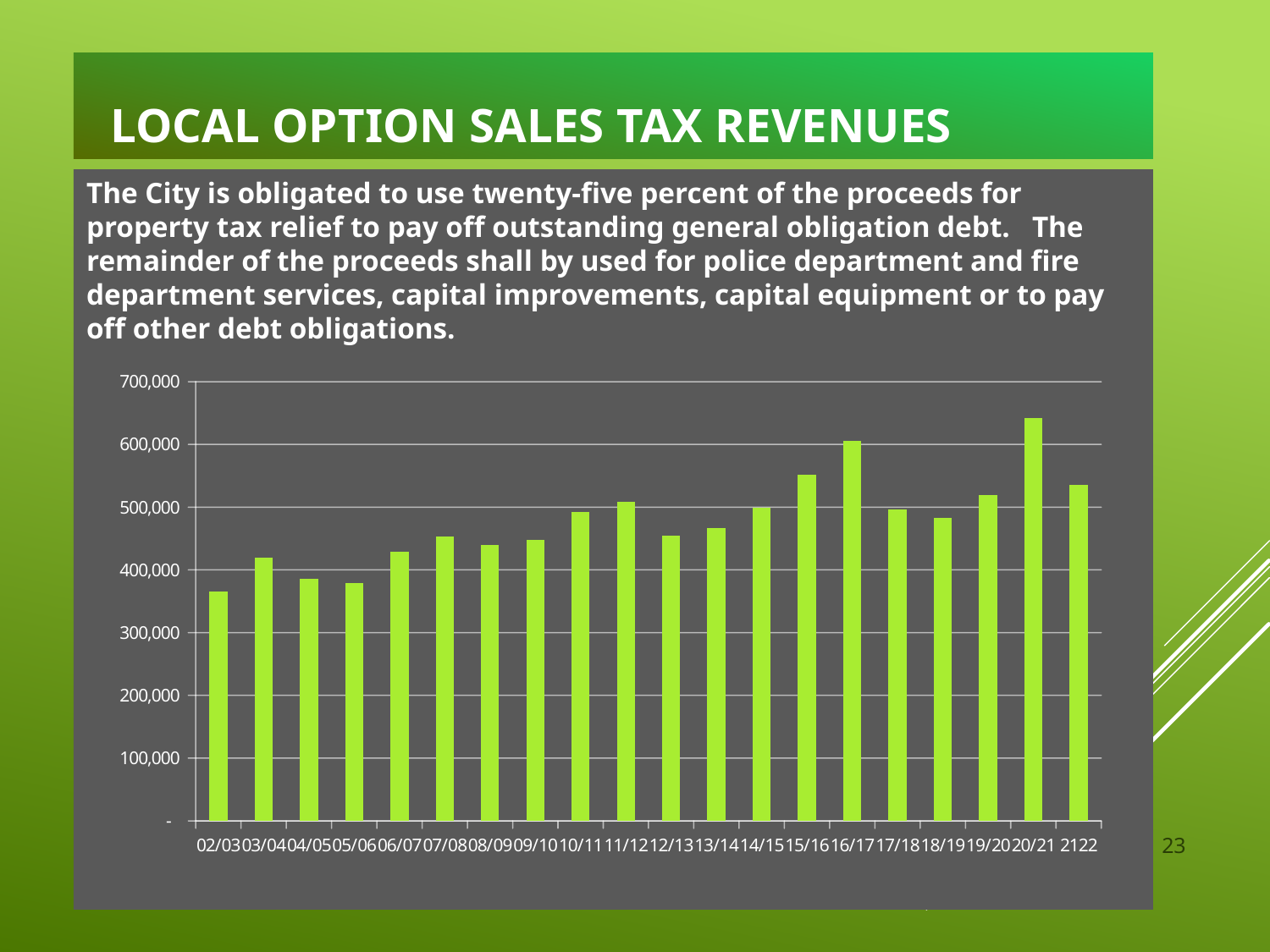
Is the value for 18/19 greater or less than 500,000? less Which fiscal year has the highest local option sales tax revenue? 20/21 Overall, do the revenues rise or fall from 02/03 to 20/21? rise Which fiscal year has the lowest local option sales tax revenue? 02/03 What kind of chart is shown on the slide? bar chart Is the value for 02/03 greater or less than 400,000? less Which is larger, the value for 15/16 or the value for 14/15? 15/16 Is the value for 20/21 greater or less than 600,000? greater Which is larger, the value for 20/21 or the value for 16/17? 20/21 How many fiscal years (bars) are plotted in the chart? 20